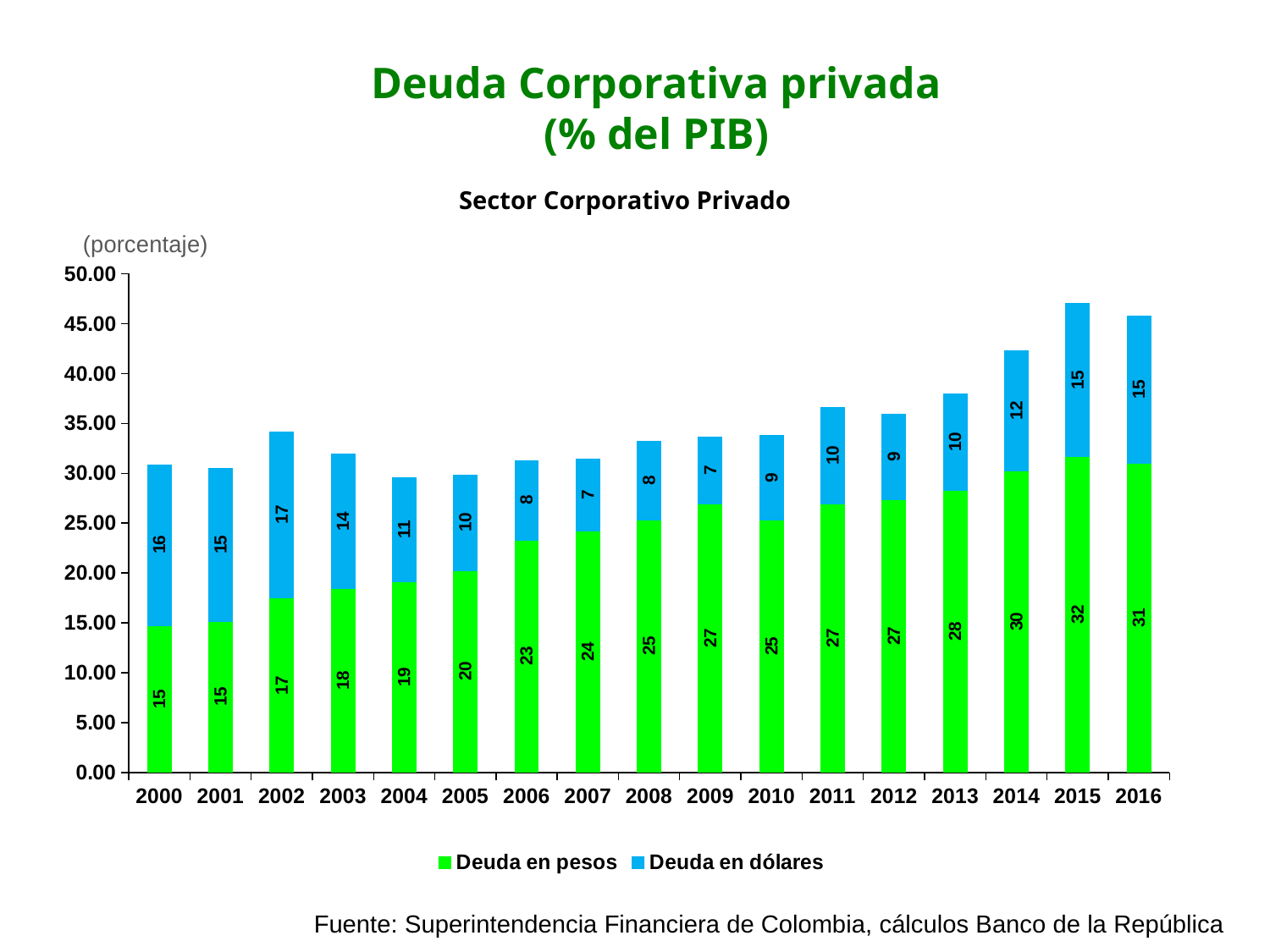
What is the value of Deuda en pesos for 2010? 25 Is the total stacked bar for 2015 greater or less than 45.00? greater In which year is Deuda en dólares highest? 2002 What is the value of Deuda en pesos for 2016? 31 Which is larger in 2003: Deuda en pesos or Deuda en dólares? Deuda en pesos What is the value of Deuda en dólares for 2004? 11 How many series does the legend list? 2 How many years are shown on the x axis? 17 What kind of chart is shown on the slide? Stacked bar chart In which year is Deuda en pesos highest? 2015 What is the difference between Deuda en pesos in 2015 and in 2000? 17